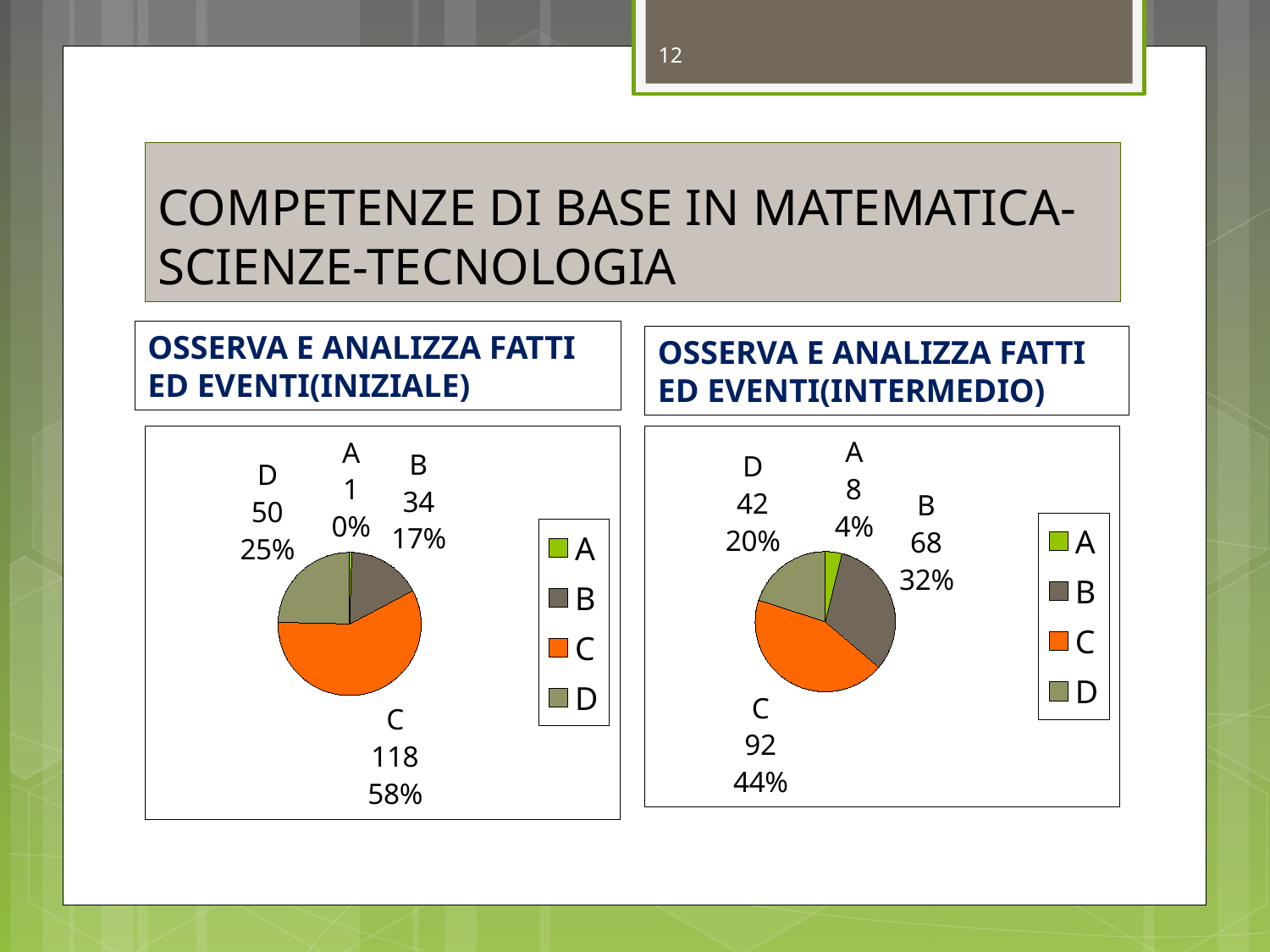
In the left pie chart (INIZIALE), what percentage share does category D have? 25% How many categories does the right pie chart (INTERMEDIO) show? 4 In the right pie chart (INTERMEDIO), which category has the smallest slice? A In the left pie chart (INIZIALE), what is the difference between the values for C and D? 68 In the right pie chart (INTERMEDIO), what is the total of all four category values? 210 In the left pie chart (INIZIALE), what colour represents category C in the legend? Orange In the right pie chart (INTERMEDIO), which is larger, the value for B or the value for D? B What type of chart is used on the left (INIZIALE)? Pie chart In the right pie chart (INTERMEDIO), what is the value for category B? 68 In the left pie chart (INIZIALE), which category has the largest slice? C In the right pie chart (INTERMEDIO), what percentage share does category C have? 44% In the left pie chart (INIZIALE), what is the value for category C? 118